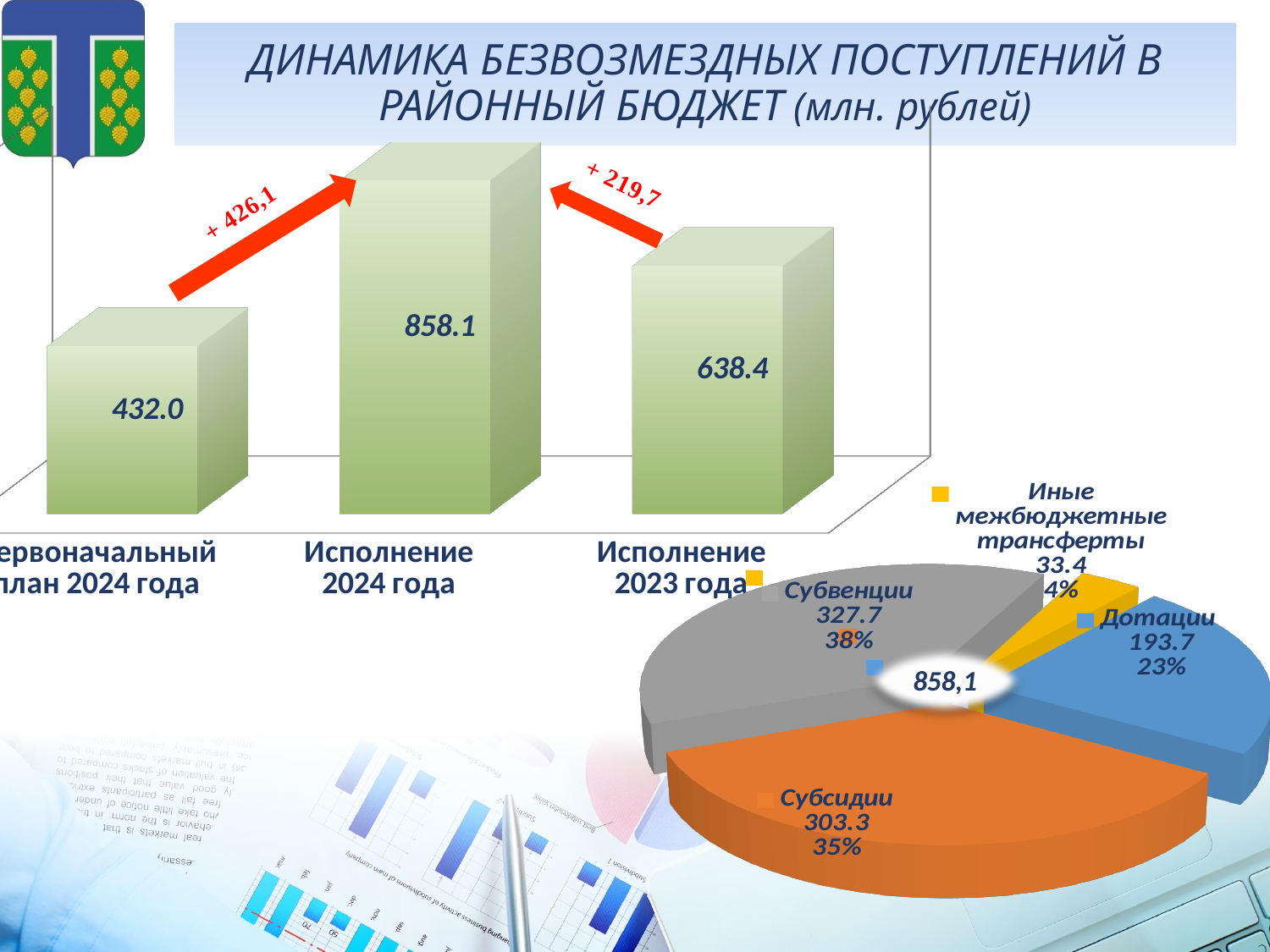
In the bar chart, how many bars are shown? 3 In the bar chart, which category has the highest value? Исполнение 2024 года What kind of chart is the chart in the upper part of the slide? bar chart In the bar chart, which category has the lowest value? Первоначальный план 2024 года In the pie chart, what is the value for Субсидии? 303.3 In the pie chart, which slice is the smallest? Иные межбюджетные трансферты In the bar chart, what is the value for Исполнение 2023 года? 638.4 In the pie chart, how many slices are there? 4 In the bar chart, what is the difference between Исполнение 2024 года and Исполнение 2023 года? 219.7 In the bar chart, what is the value for Первоначальный план 2024 года? 432.0 In the bar chart, what is the value for Исполнение 2024 года? 858.1 In the pie chart, what share does Субвенции have? 38%